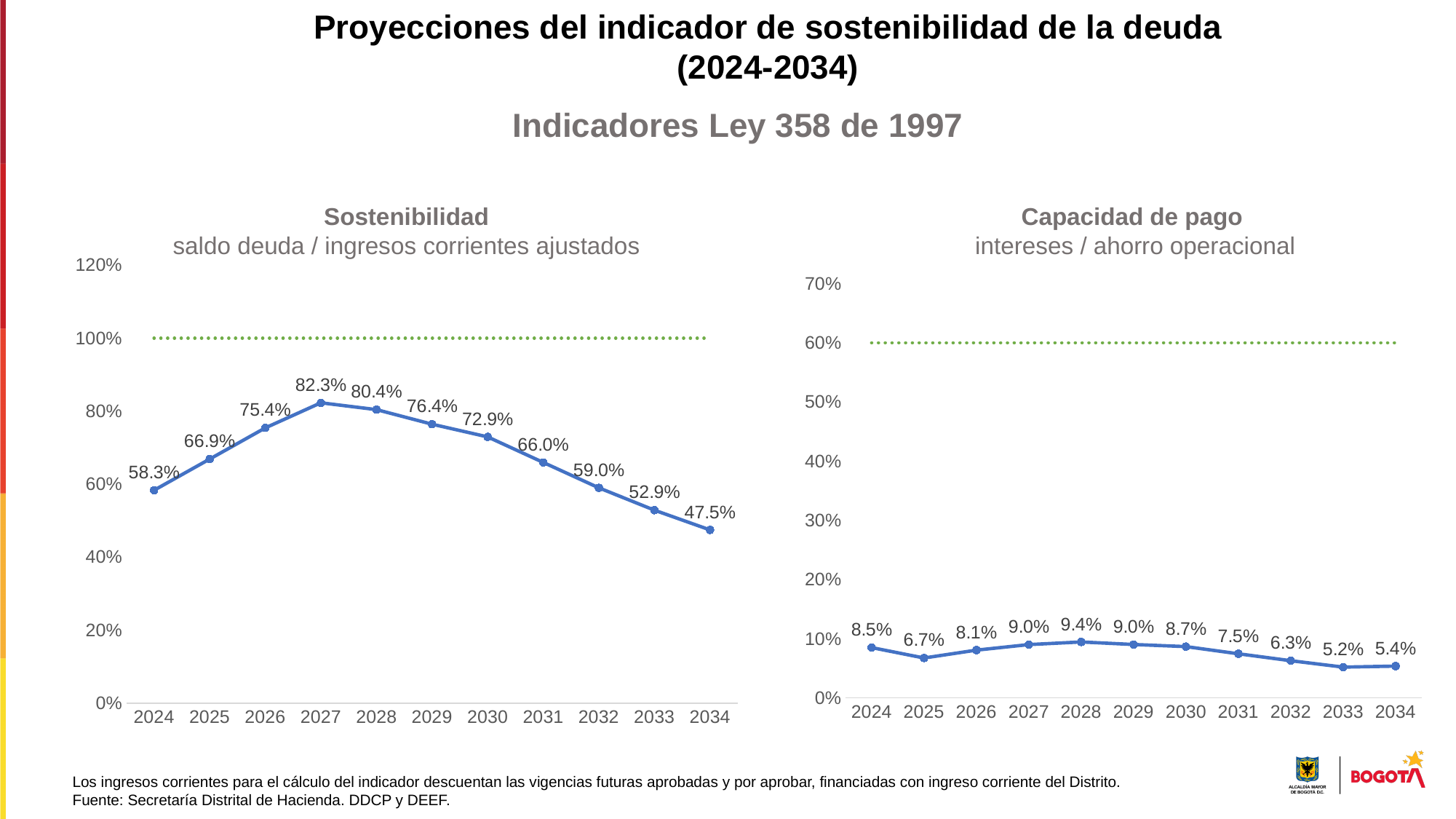
In the Sostenibilidad chart, what is the value for 2027? 82.3% In the Capacidad de pago chart, what is the value for 2028? 9.4% In the Capacidad de pago chart, which is larger, the value for 2024 or the value for 2025? 2024 In the Sostenibilidad chart, do the values rise or fall from 2028 to 2034? fall In the Sostenibilidad chart, is the value for 2024 greater or less than 60%? less In the Sostenibilidad chart, which year has the highest value? 2027 In the Sostenibilidad chart, what is the difference between the values for 2027 and 2034? 34.8% In the Capacidad de pago chart, what is the difference between the values for 2024 and 2034? 3.1% In the Sostenibilidad chart, which year has the lowest value? 2034 In the Capacidad de pago chart, which year has the lowest value? 2033 What kind of chart is the Sostenibilidad chart? line chart How many years are plotted in the Capacidad de pago chart? 11